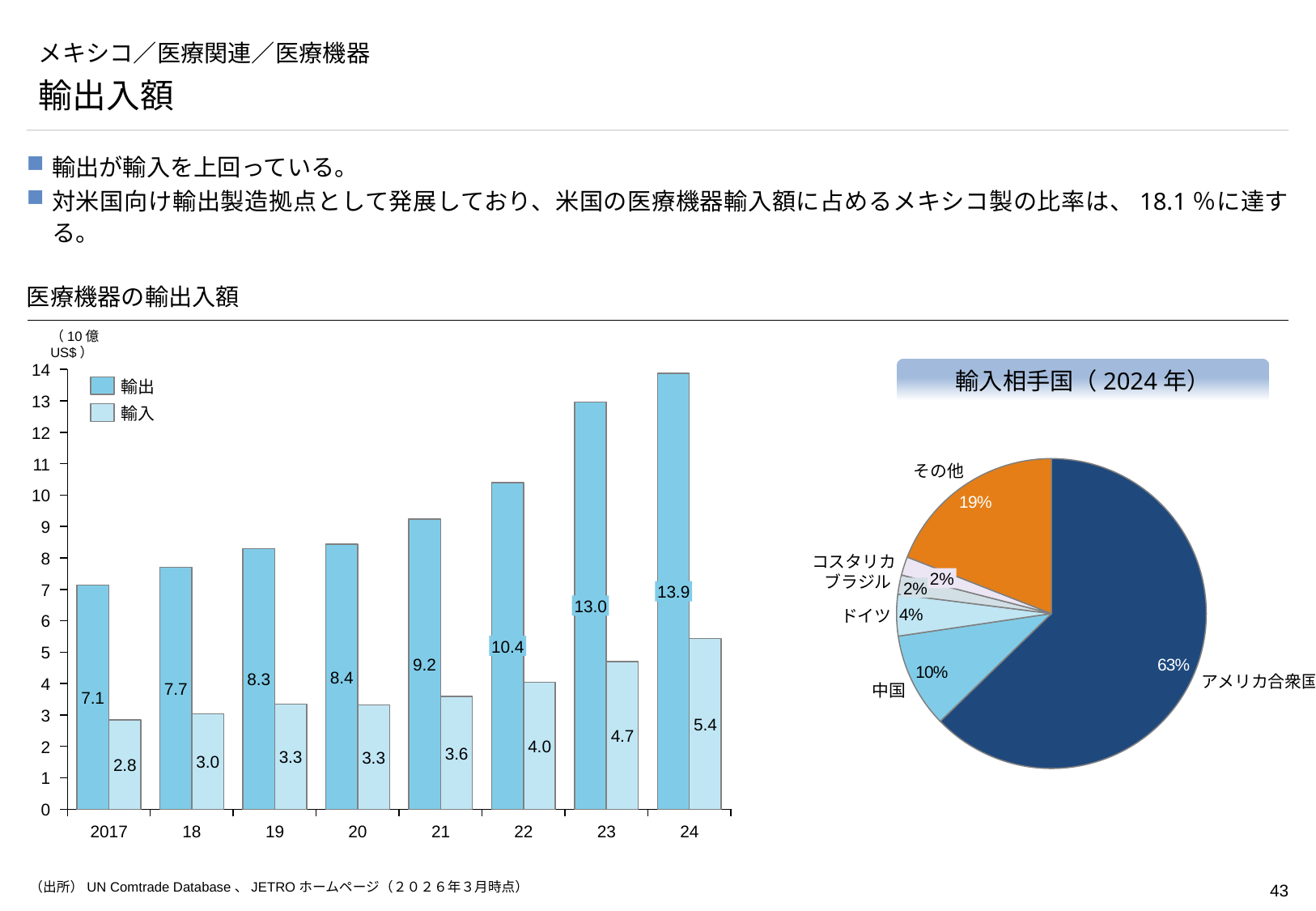
「輸入相手国（2024年）」の円グラフで、ドイツとその他ではどちらの割合が大きいですか。 その他 「輸入相手国（2024年）」の円グラフで、アメリカ合衆国の割合はいくらですか。 63% 「医療機器の輸出入額」のグラフは何種類のグラフですか。 棒グラフ 「医療機器の輸出入額」のグラフで、輸入が最も低い年はどれですか。 2017 「医療機器の輸出入額」のグラフで、2017年の輸入の値はいくらですか。 2.8 「医療機器の輸出入額」のグラフで、輸出が最も高い年はどれですか。 24 「輸入相手国（2024年）」の円グラフで、中国の割合はいくらですか。 10% 「医療機器の輸出入額」のグラフで、2024年の輸出と輸入の差はいくらですか。 8.5 「医療機器の輸出入額」のグラフで、2024年の輸出の値はいくらですか。 13.9 「医療機器の輸出入額」のグラフで、2022年の輸出と2023年の輸出ではどちらが大きいですか。 2023年の輸出 「医療機器の輸出入額」のグラフで、輸出は2017年から2024年にかけて増加していますか、減少していますか。 増加 「医療機器の輸出入額」のグラフで、凡例にはいくつの系列がありますか。 2